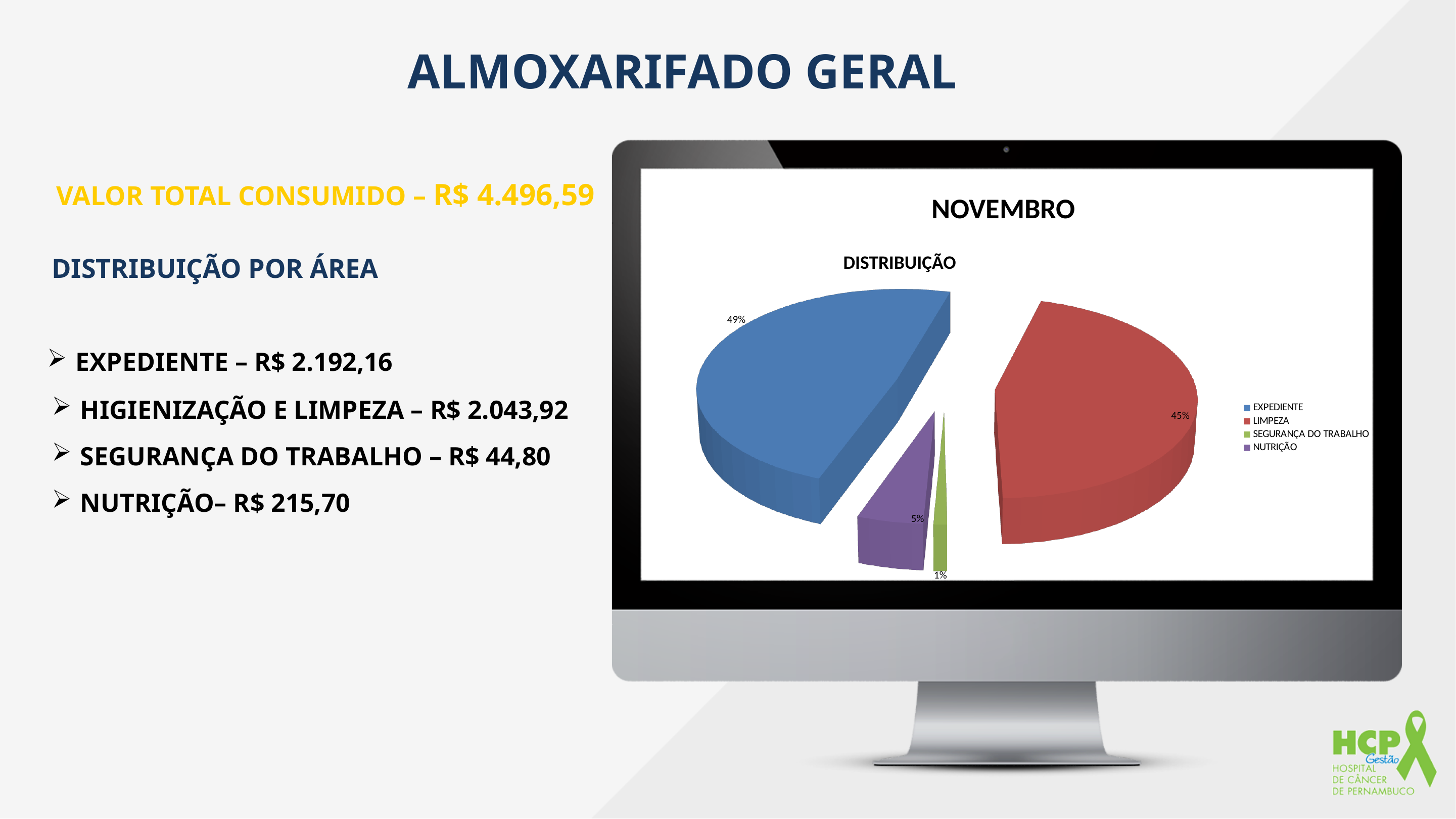
By how many percentage points does the EXPEDIENTE slice exceed the LIMPEZA slice? 4 percentage points Which category has the largest slice of the pie chart? EXPEDIENTE What percentage of the pie chart does EXPEDIENTE represent? 49% What percentage of the pie chart does SEGURANÇA DO TRABALHO represent? 1% What is the title of the chart? DISTRIBUIÇÃO What percentage of the pie chart does LIMPEZA represent? 45% How many entries does the chart legend list? 4 How many slices does the pie chart have? 4 What type of chart is shown on the slide? Pie chart Which slice is larger, NUTRIÇÃO or SEGURANÇA DO TRABALHO? NUTRIÇÃO What percentage of the pie chart does NUTRIÇÃO represent? 5% Which category has the smallest slice of the pie chart? SEGURANÇA DO TRABALHO